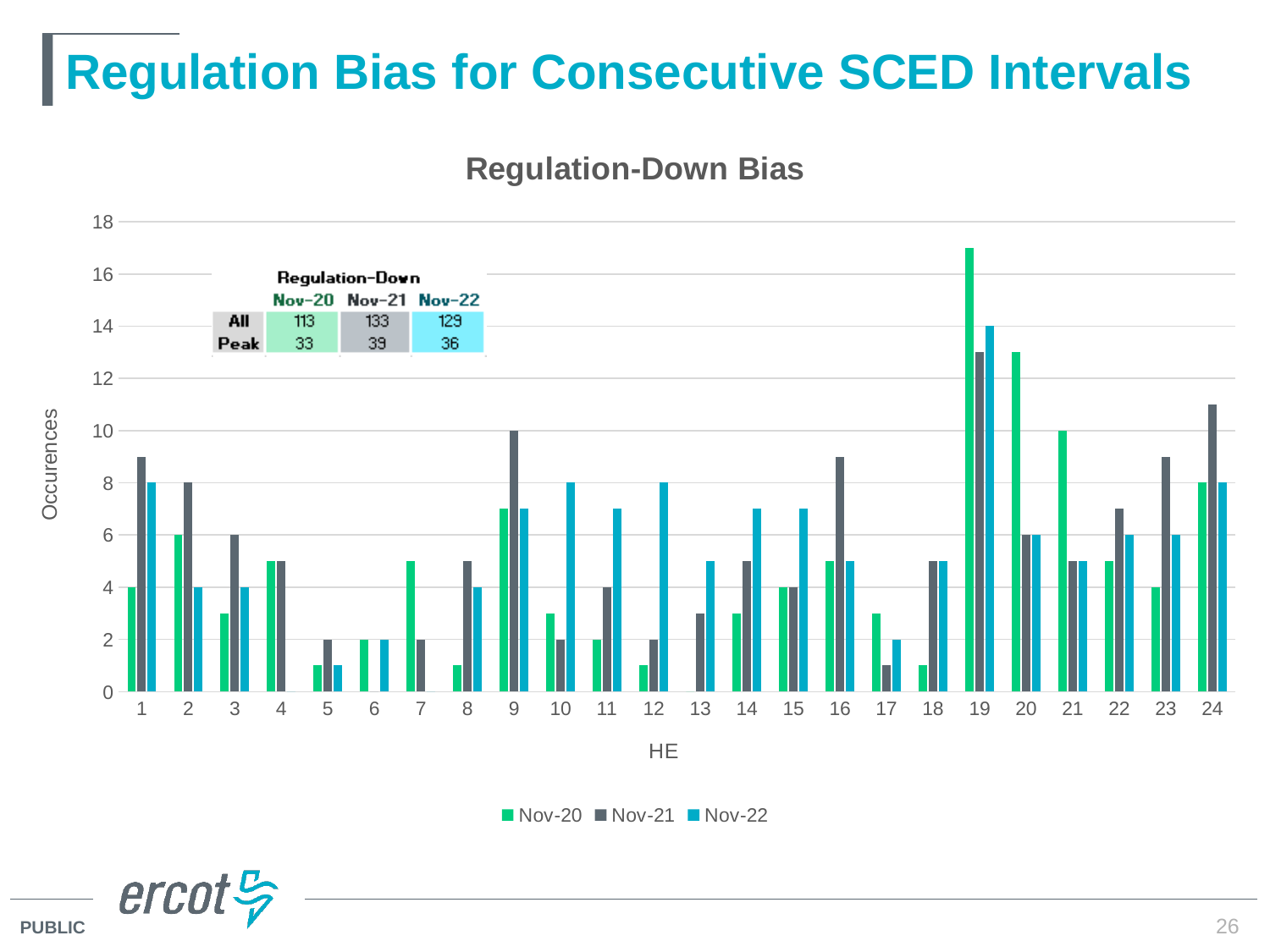
How many HE categories are shown along the x axis? 24 What is the Nov-22 value for HE 1? 8 How many series does the chart legend list? 3 According to the inset table, what is the 'Peak' value for Nov-22? 36 What type of chart is shown on the slide? bar chart At HE 9, which is larger: the Nov-20 value or the Nov-21 value? Nov-21 According to the inset table, what is the 'All' value for Nov-21? 133 In the inset table, what is the difference between the 'All' values for Nov-21 and Nov-20? 20 What is the title of the chart? Regulation-Down Bias In the inset table, which month has the highest 'All' value? Nov-21 Is the Nov-20 value for HE 19 greater or less than 16? greater Which HE has the tallest bar in the chart? 19